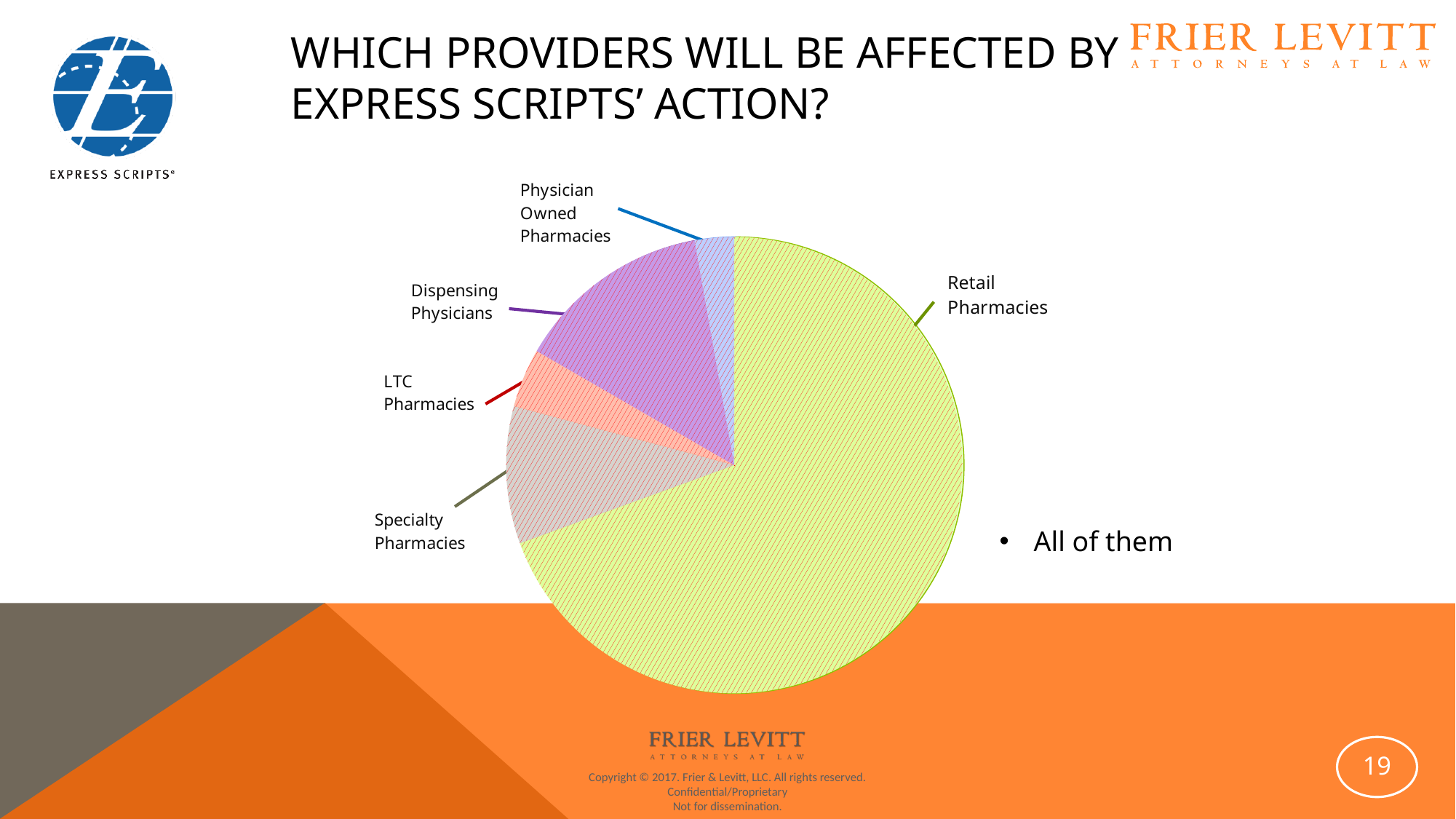
What kind of chart is shown on the slide? Pie chart Which slice is larger, Dispensing Physicians or LTC Pharmacies? Dispensing Physicians Which slice is larger, Retail Pharmacies or Specialty Pharmacies? Retail Pharmacies Which slice is larger, Specialty Pharmacies or Physician Owned Pharmacies? Specialty Pharmacies How many slices does the pie chart have? 5 What colour is the Retail Pharmacies slice of the pie chart? Yellow-green Does the Retail Pharmacies slice account for more or less than half of the pie? more What text appears in the bullet point to the right of the pie chart? All of them Which category has the largest slice of the pie chart? Retail Pharmacies